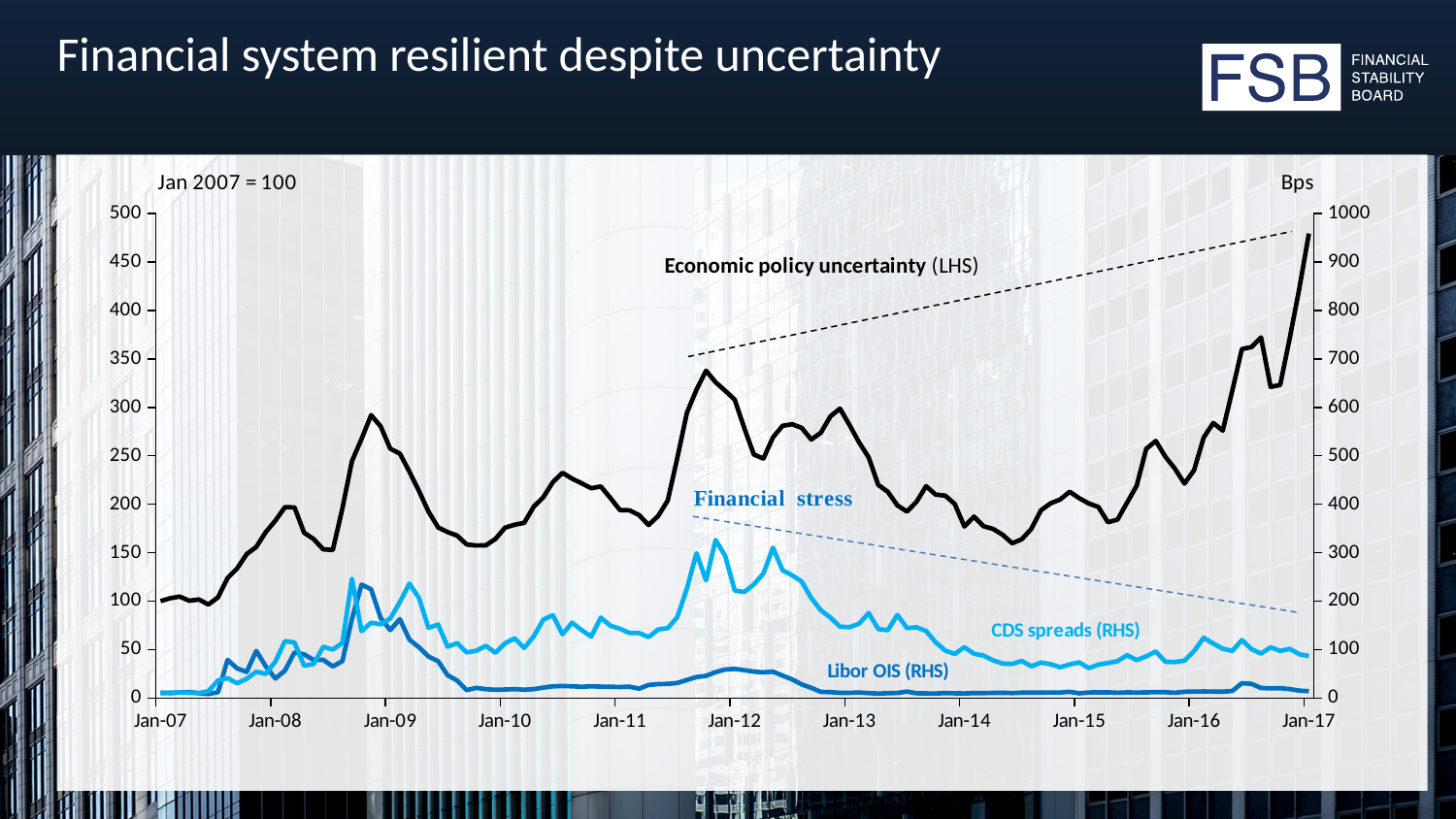
Do CDS spreads rise or fall between Jan-12 and Jan-14? fall Does Economic policy uncertainty rise or fall between Jan-14 and Jan-17? rise How many year labels are shown on the x axis? 11 Which series is plotted against the left-hand axis (LHS)? Economic policy uncertainty What unit is shown at the top of the right-hand axis? Bps Is the value of Libor OIS at Jan-17 greater or less than 100 bps? less How many data series are plotted on the chart? 3 What kind of chart is shown on the slide? Line chart Is the value of Economic policy uncertainty at Jan-17 greater or less than 400? greater Is the value of Economic policy uncertainty at Jan-07 greater or less than 150? less At Jan-17, which is higher: CDS spreads or Libor OIS? CDS spreads